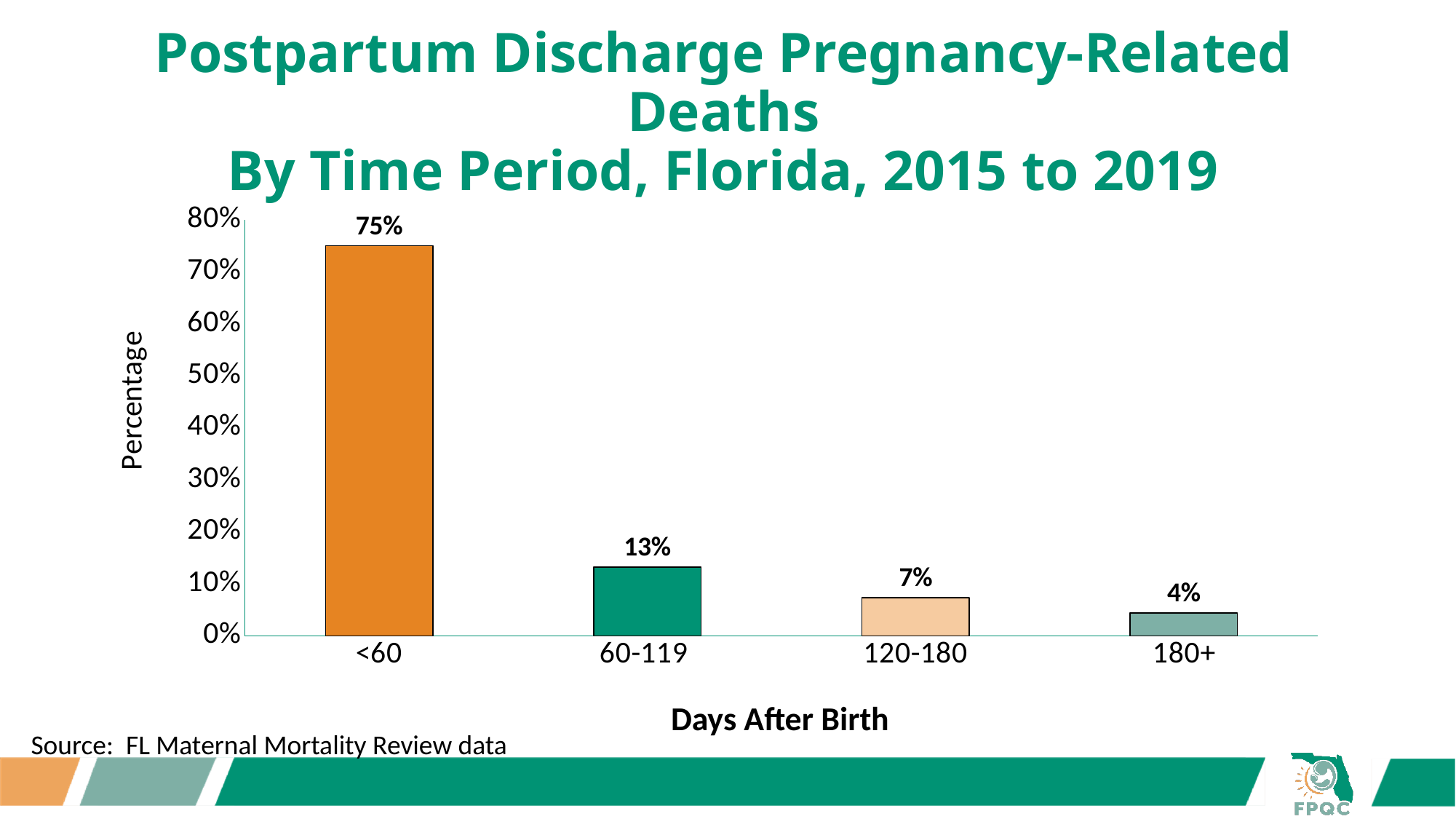
What is the difference between the <60 and 60-119 categories? 62% Is the value for 60-119 greater or less than 10%? greater What percentage of postpartum discharge pregnancy-related deaths occurred at <60 days after birth? 75% What is the value for the 180+ days after birth category? 4% What is the value for the 60-119 days after birth category? 13% What kind of chart is shown on the slide? Bar chart Which time period has the lowest percentage of deaths? 180+ How many time period categories are shown on the x axis? 4 Which time period has the highest percentage of deaths? <60 Do the values rise or fall as the time period after birth increases along the x axis? Fall What is the value for the 120-180 days after birth category? 7% Which is larger, the value for 120-180 or the value for 180+? 120-180